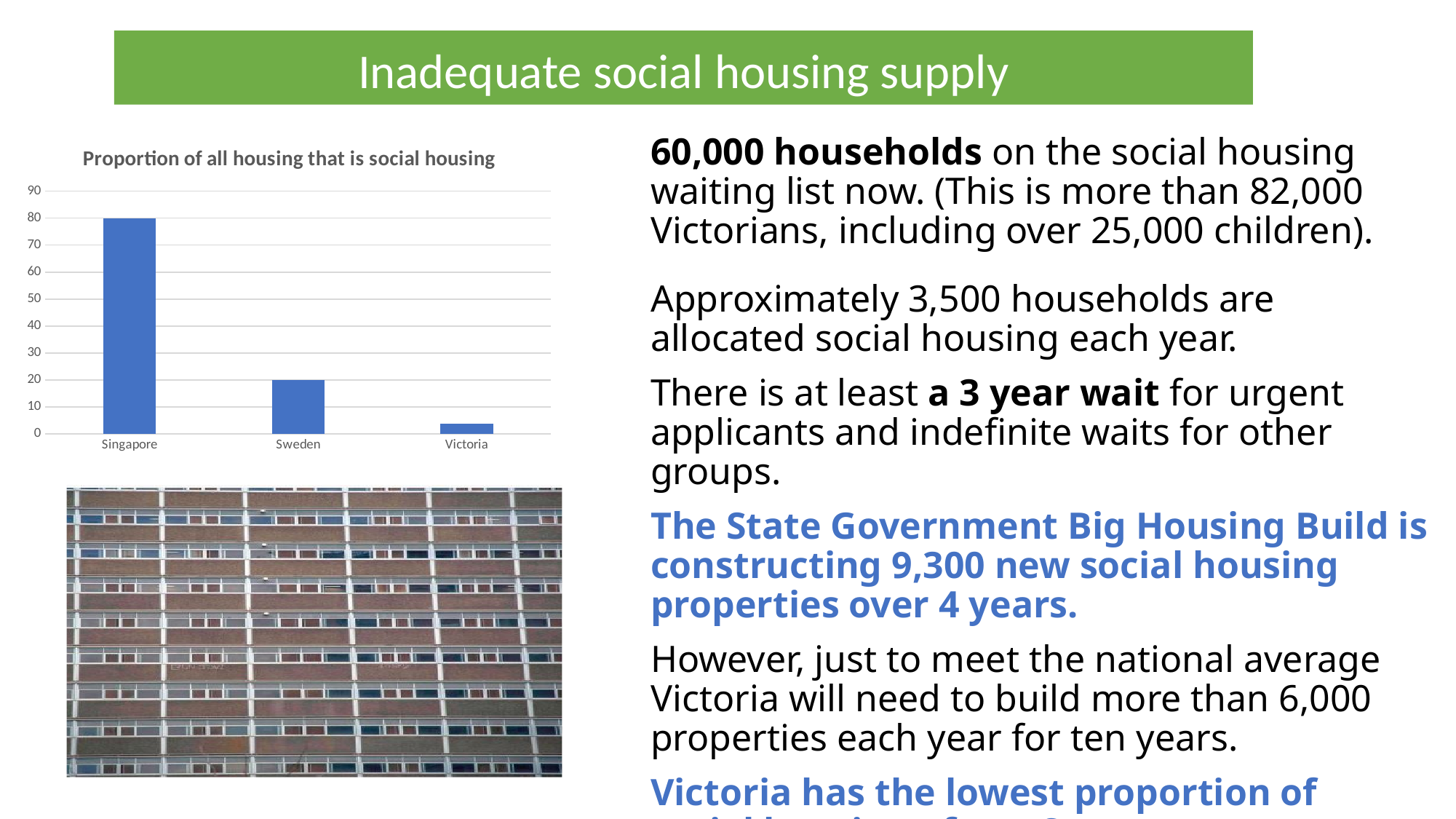
Do the values rise or fall from left to right across the categories? fall Which has a larger value in the chart, Sweden or Victoria? Sweden What is the title of the chart? Proportion of all housing that is social housing What kind of chart is shown on the slide? bar chart What is the value for Singapore in the chart? 80 Which category has the highest proportion of social housing in the chart? Singapore What is the value for Sweden in the chart? 20 Is the value for Sweden greater or less than 30? less How many categories are plotted in the chart? 3 Which category has the lowest proportion of social housing in the chart? Victoria Is the value for Singapore greater or less than 70? greater Is the value for Victoria greater or less than 10? less